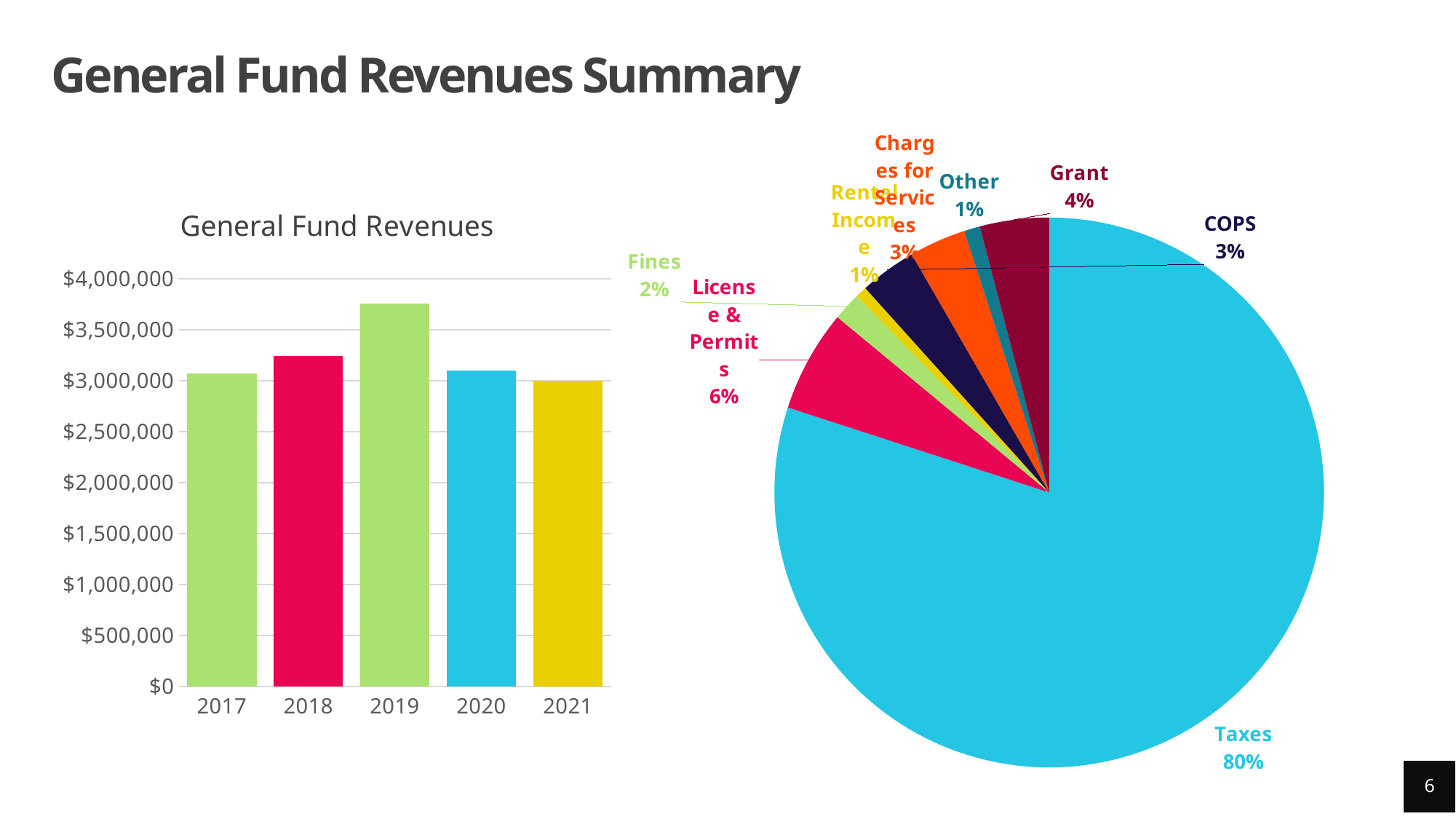
In the General Fund Revenues bar chart, which year has the highest revenue? 2019 In the General Fund Revenues bar chart, is the value for 2019 greater or less than $3,500,000? greater In the pie chart on the right, how many slices are there? 8 In the pie chart on the right, which category has the largest share? Taxes In the pie chart on the right, what share does Licenses & Permits have? 6% In the General Fund Revenues bar chart, is the value for 2018 greater or less than $3,500,000? less In the pie chart on the right, what share does Taxes have? 80% In the General Fund Revenues bar chart, which is larger, the value for 2017 or the value for 2018? 2018 What type of chart is the General Fund Revenues chart on the left? bar chart In the pie chart on the right, what share does Grant have? 4% In the General Fund Revenues bar chart, is the value for 2017 greater or less than $2,500,000? greater In the General Fund Revenues bar chart, how many years are shown? 5